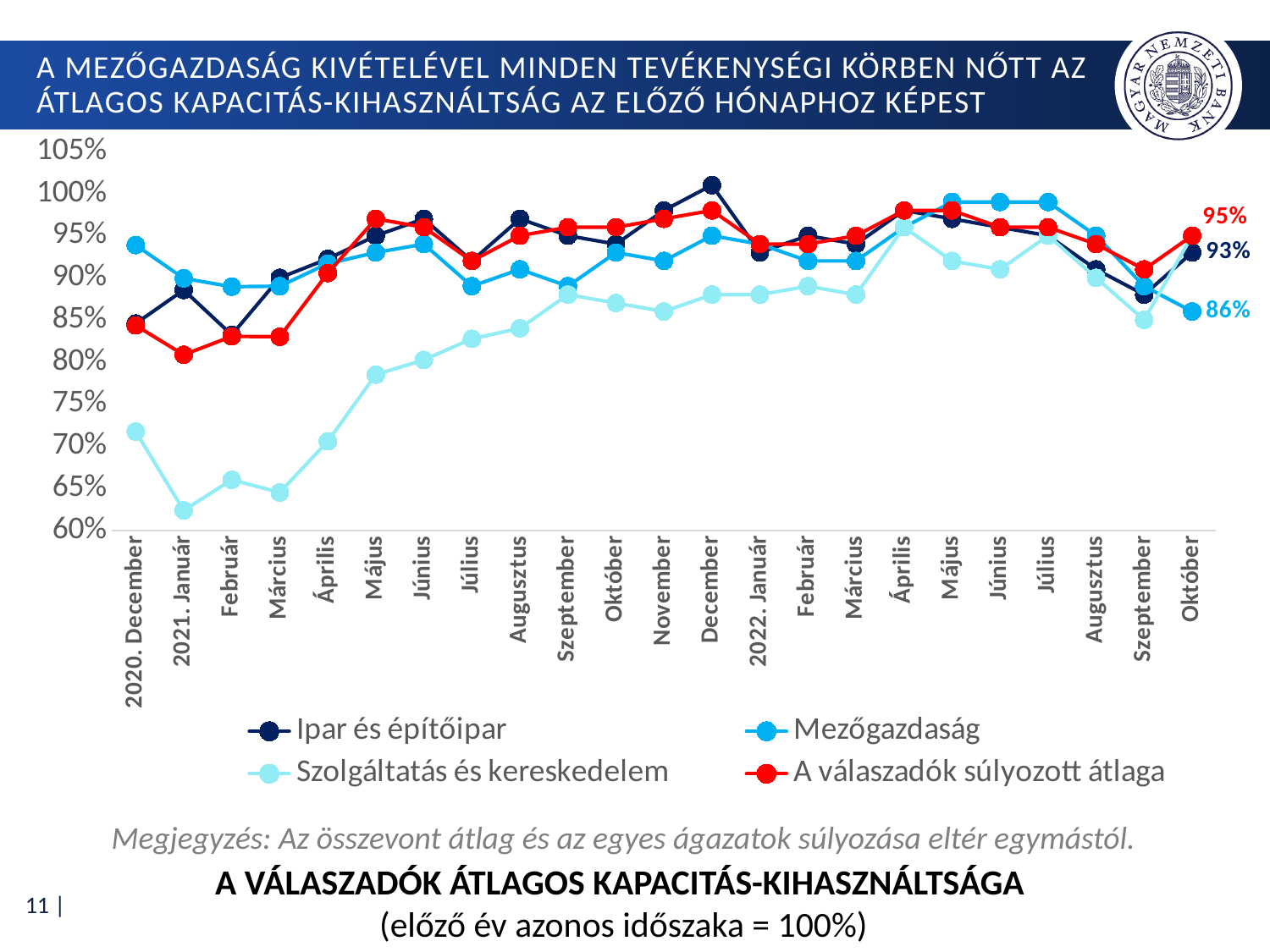
In 2022 Október, what is the difference between Ipar és építőipar and Mezőgazdaság? 7 percentage points What is the value of Mezőgazdaság in 2022 Október? 86% How many series does the legend list? 4 What is the value of A válaszadók súlyozott átlaga in 2022 Október? 95% Does Szolgáltatás és kereskedelem rise or fall from 2021 Március to 2021 Szeptember? rise What is the value of Ipar és építőipar in 2022 Október? 93% What kind of chart is shown on the slide? Line chart How many months are plotted on the x axis? 23 In which month does Szolgáltatás és kereskedelem reach its lowest value? 2021. Január In 2022 Október, which is higher: A válaszadók súlyozott átlaga or Mezőgazdaság? A válaszadók súlyozott átlaga In 2022 Október, how many percentage points higher is A válaszadók súlyozott átlaga than Mezőgazdaság? 9 percentage points Is the value for Szolgáltatás és kereskedelem in 2020. December greater or less than 75%? less